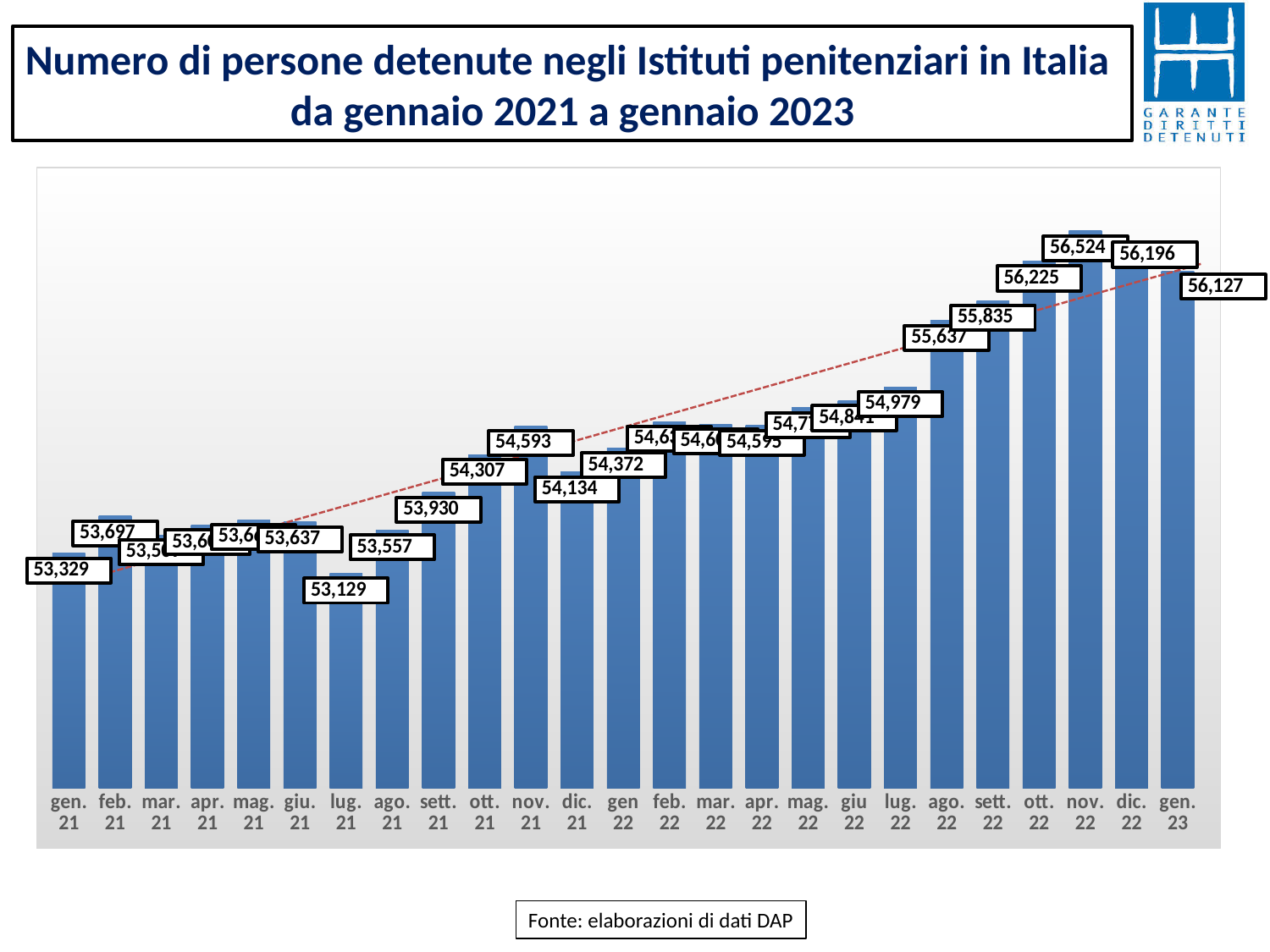
Which is larger, the value for nov. 21 or the value for dic. 21? nov. 21 What source is cited below the chart? Fonte: elaborazioni di dati DAP What is the value shown for lug. 21? 53,129 What is the number of detained persons shown for gen. 21? 53,329 What is the difference between the value for nov. 22 and the value for lug. 21? 3,395 Overall, do the values rise or fall from gen. 21 to gen. 23? Rise What is the value shown for nov. 22? 56,524 What type of chart is shown on the slide? Bar chart How many months (bars) are plotted in the chart? 25 Which month has the highest number of detained persons? nov. 22 What is the value shown for gen. 23? 56,127 Which month has the lowest number of detained persons? lug. 21